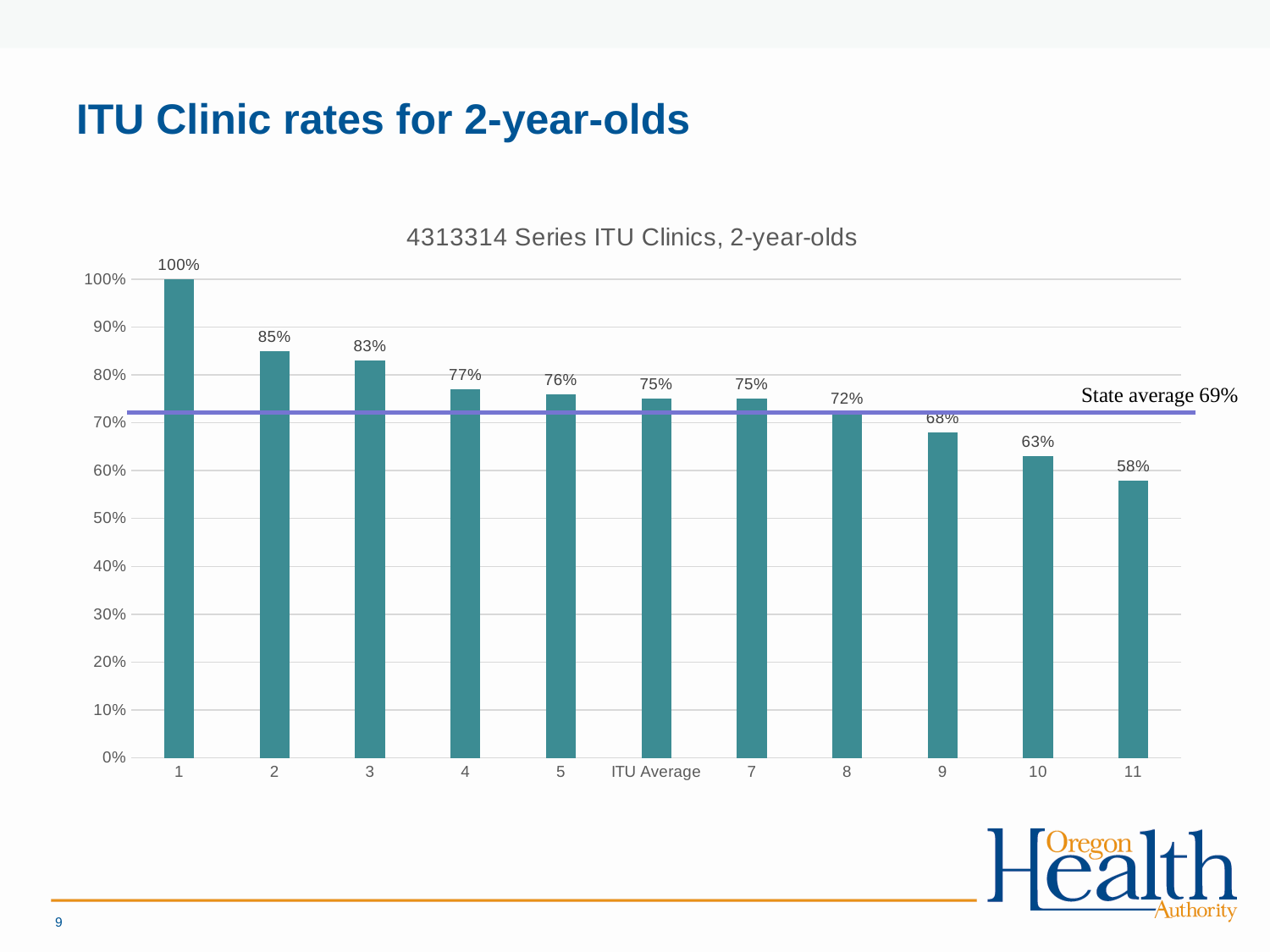
What is the value for ITU Average? 75% What is the value for clinic 11? 58% Do the bar values rise or fall from left to right along the x axis? Fall Which is larger, the value for clinic 3 or the value for clinic 8? 3 How many bars are plotted in the chart? 11 What is the value for clinic 9? 68% What is the difference between the values for clinic 2 and clinic 10? 22% Which category has the lowest value? 11 Which category has the highest value? 1 What is the value for clinic 1? 100% What state average does the horizontal line on the chart indicate? 69% What kind of chart is shown? Bar chart